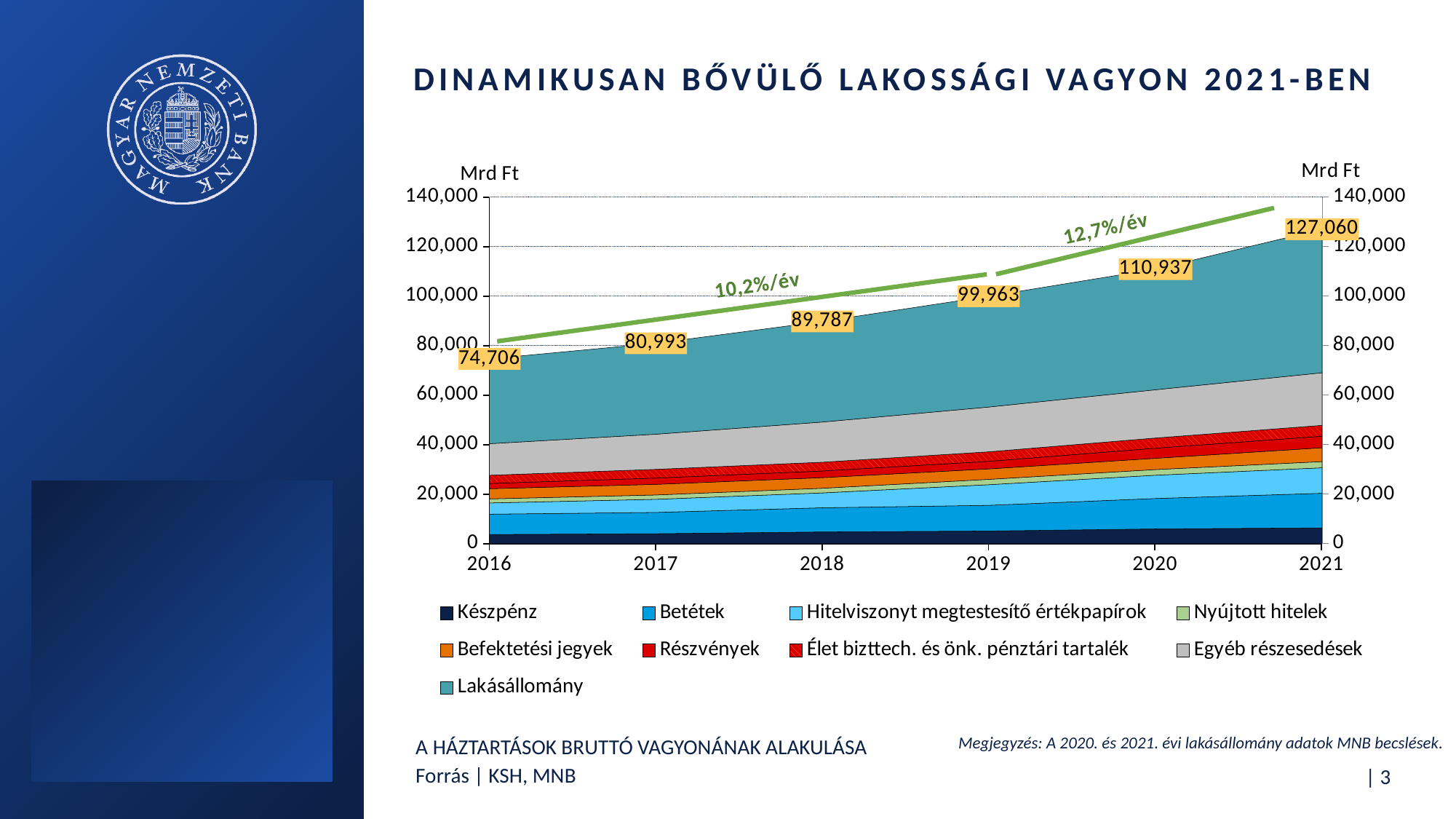
By how much did the total value increase from 2020 to 2021? 16,123 What is the difference between the total values for 2018 and 2017? 8,794 What is the total value labelled for 2019? 99,963 Which year has the lowest total value? 2016 What is the total household gross wealth shown for 2021? 127,060 What annual growth rate is annotated for the period from 2019 to 2021? 12,7%/év How many years are shown on the x axis? 6 What kind of chart is shown on the slide? stacked area chart How many series does the legend list? 9 Is the total value for 2020 greater or less than 100,000? greater What is the total value labelled for 2016? 74,706 Which year has the highest total value? 2021